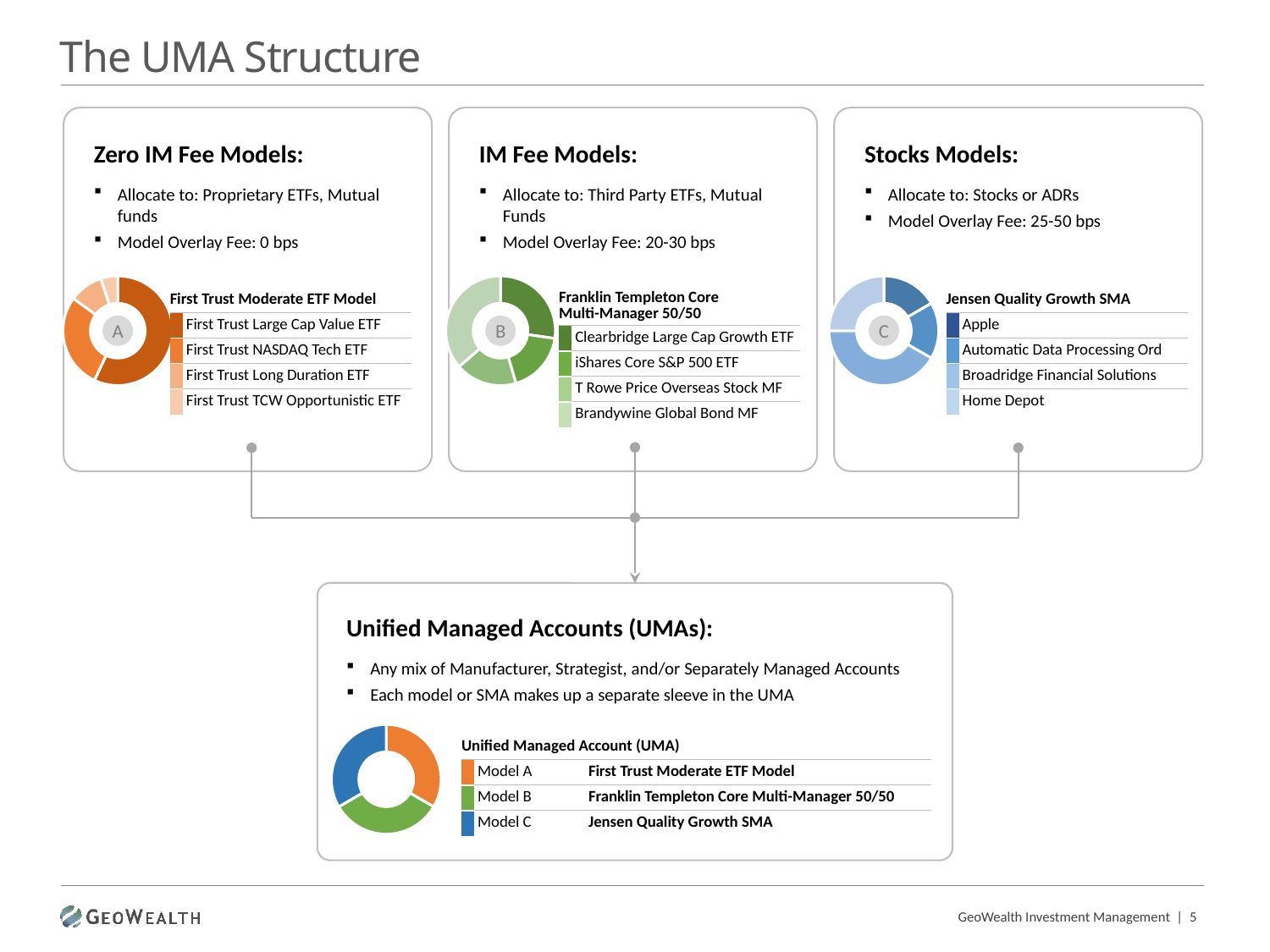
What colour represents Model A in the Unified Managed Account (UMA) chart? Orange In the Unified Managed Account (UMA) chart, which model corresponds to the Jensen Quality Growth SMA? Model C How many holdings does the legend of the Franklin Templeton Core Multi-Manager 50/50 chart list? 4 How many holdings does the legend of the First Trust Moderate ETF Model chart list? 4 In the First Trust Moderate ETF Model chart, which holding has the largest slice? First Trust Large Cap Value ETF How many donut charts are shown on the slide? 4 What kind of chart is used for the First Trust Moderate ETF Model? Donut (pie) chart Which holding is listed last in the legend of the Franklin Templeton Core Multi-Manager 50/50 chart? Brandywine Global Bond MF